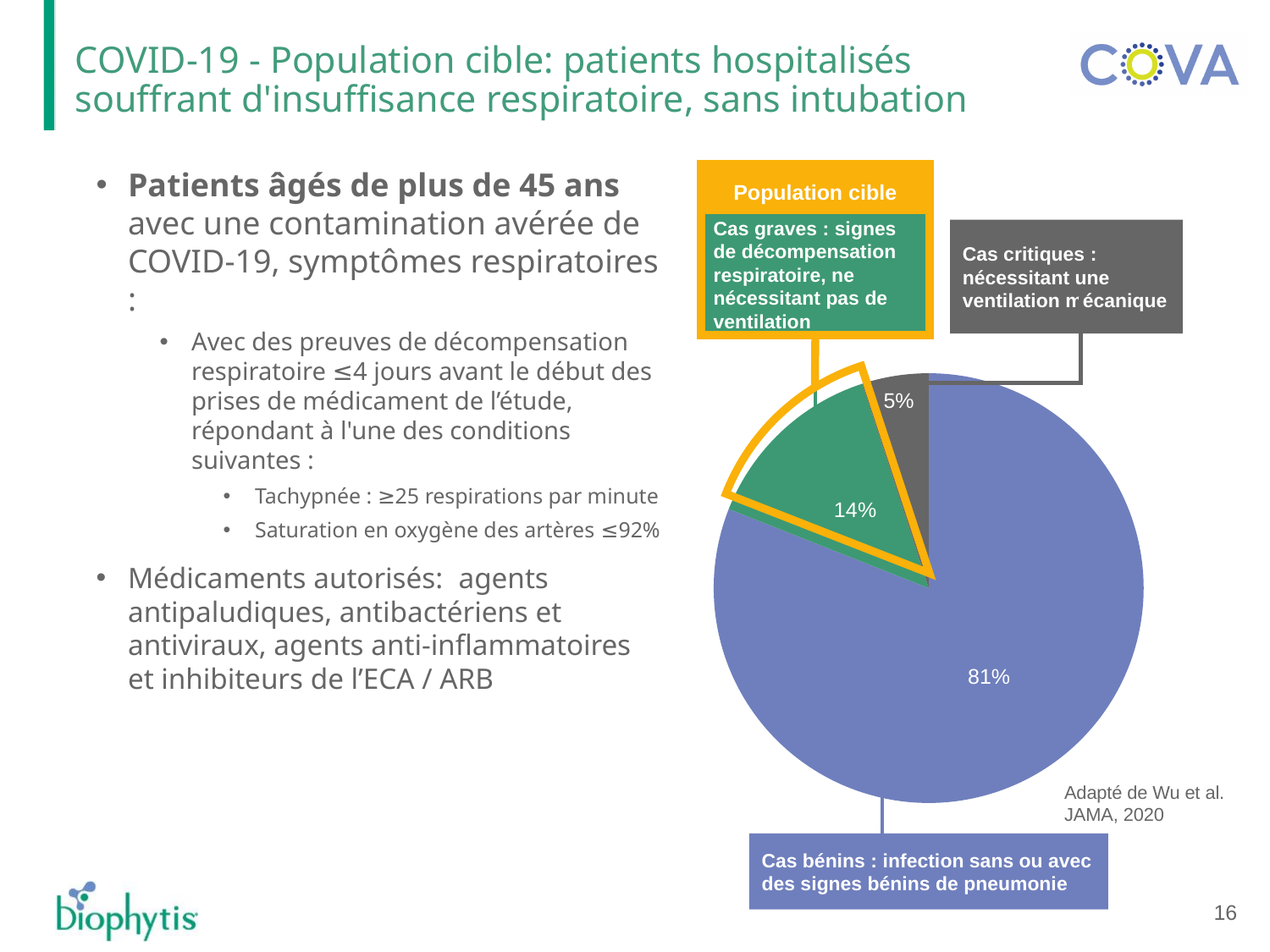
What is the difference in percentage points between the 'Cas graves' slice and the 'Cas critiques' slice? 9 What is the difference in percentage points between the 'Cas bénins' slice and the 'Cas graves' slice? 67 Which slice of the pie is highlighted with an orange outline as the 'Population cible'? Cas graves (14%) What share of the pie corresponds to 'Cas graves' (signes de décompensation respiratoire, ne nécessitant pas de ventilation)? 14% What share of the pie corresponds to 'Cas critiques : nécessitant une ventilation mécanique'? 5% What colour is the 'Cas bénins' slice of the pie? blue Which is larger, the 'Cas graves' slice or the 'Cas critiques' slice? Cas graves How many slices does the pie chart have? 3 Which category has the smallest slice of the pie? Cas critiques Which category has the largest slice of the pie? Cas bénins What share of the pie is labelled 'Cas bénins : infection sans ou avec des signes bénins de pneumonie'? 81% What kind of chart is shown on the slide? pie chart